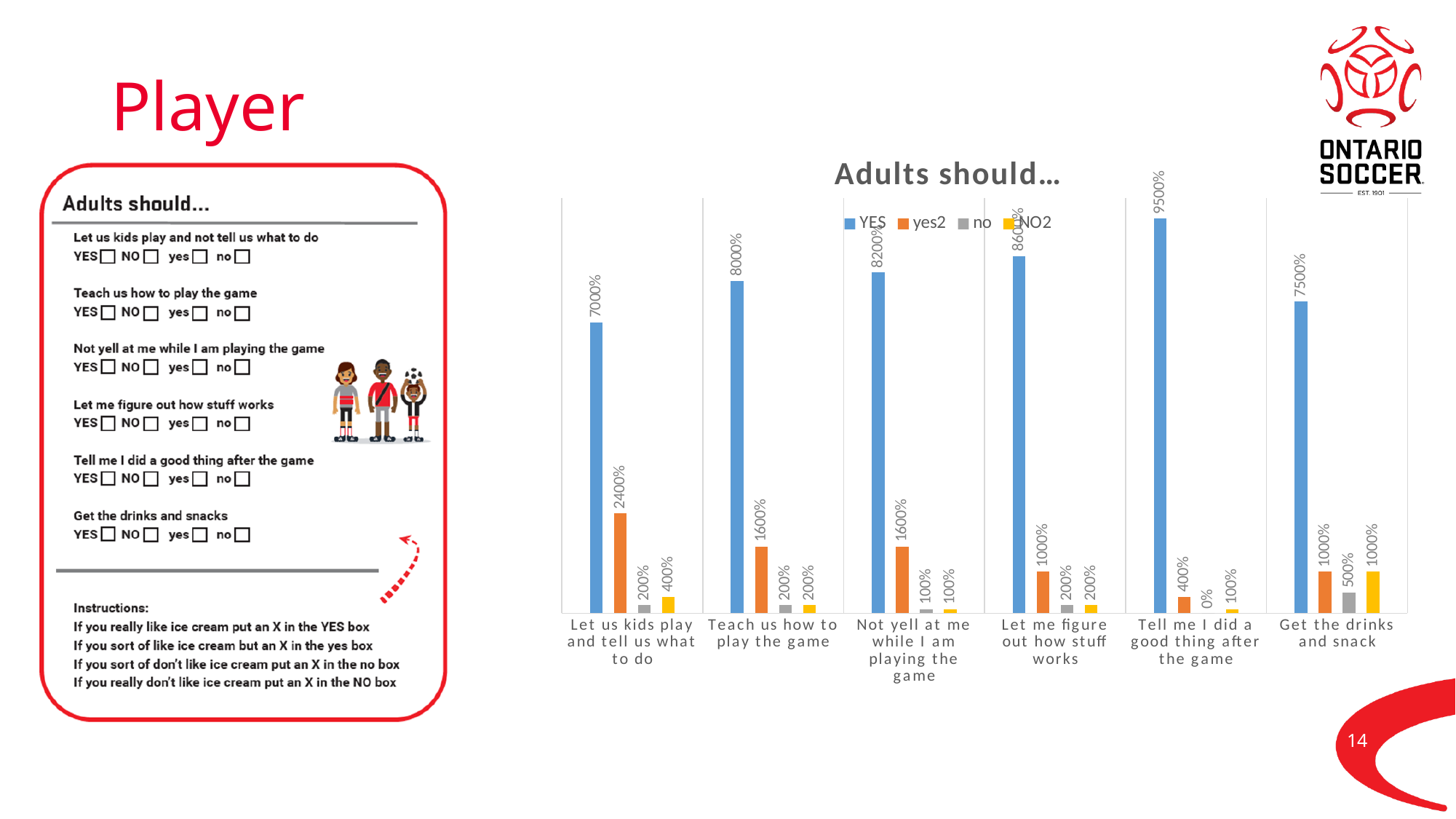
How many series does the legend list? 4 What is the "no" value for "Tell me I did a good thing after the game"? 0% What is the title of the chart? Adults should… What is the NO2 value for "Get the drinks and snack"? 1000% Which category has the lowest YES value? Let us kids play and tell us what to do What is the yes2 value for "Let us kids play and tell us what to do"? 2400% What is the difference between the YES values for "Let me figure out how stuff works" and "Teach us how to play the game"? 600% How many categories are shown on the x axis? 6 Which is larger: the yes2 value for "Teach us how to play the game" or the yes2 value for "Tell me I did a good thing after the game"? Teach us how to play the game Which category has the highest YES value? Tell me I did a good thing after the game What is the YES value for "Tell me I did a good thing after the game"? 9500% What kind of chart is shown? Bar chart